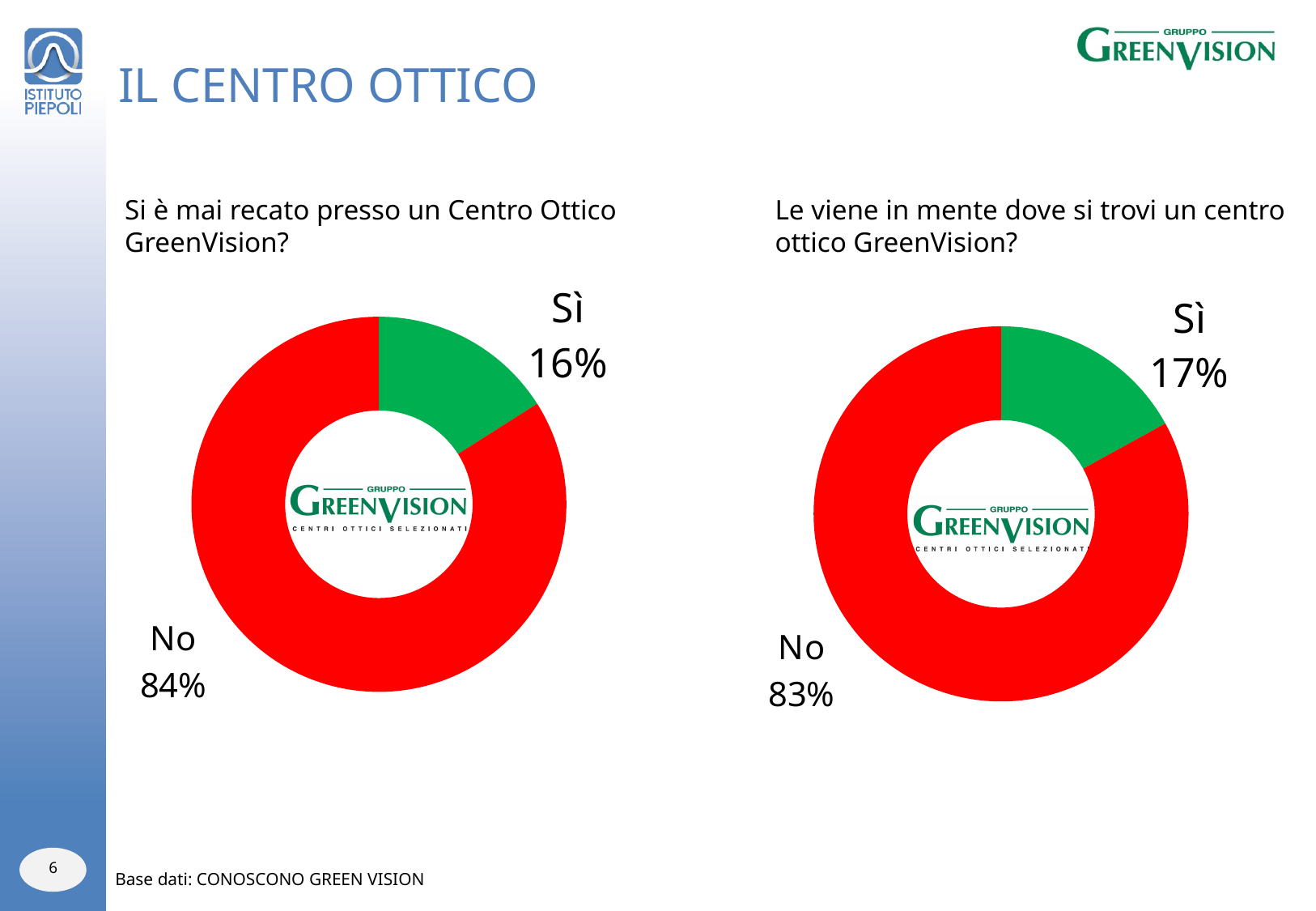
In the right chart ("Le viene in mente dove si trovi un centro ottico GreenVision?"), what percentage answered No? 83% In the left chart ("Si è mai recato presso un Centro Ottico GreenVision?"), what percentage answered No? 84% Which is larger: the Sì share in the left chart or the Sì share in the right chart? The right chart (17%) In the left chart, what is the difference between the No and Sì percentages? 68% In the left chart ("Si è mai recato presso un Centro Ottico GreenVision?"), what percentage answered Sì? 16% How many categories does the right chart show? 2 In the right chart, what is the difference between the No and Sì percentages? 66% In the right chart, which answer has the smallest share? Sì In the right chart ("Le viene in mente dove si trovi un centro ottico GreenVision?"), what percentage answered Sì? 17% In the left chart, what colour is the Sì slice? Green What type of chart is used on the left of the slide? Doughnut (pie) chart In the left chart, which answer has the largest share? No